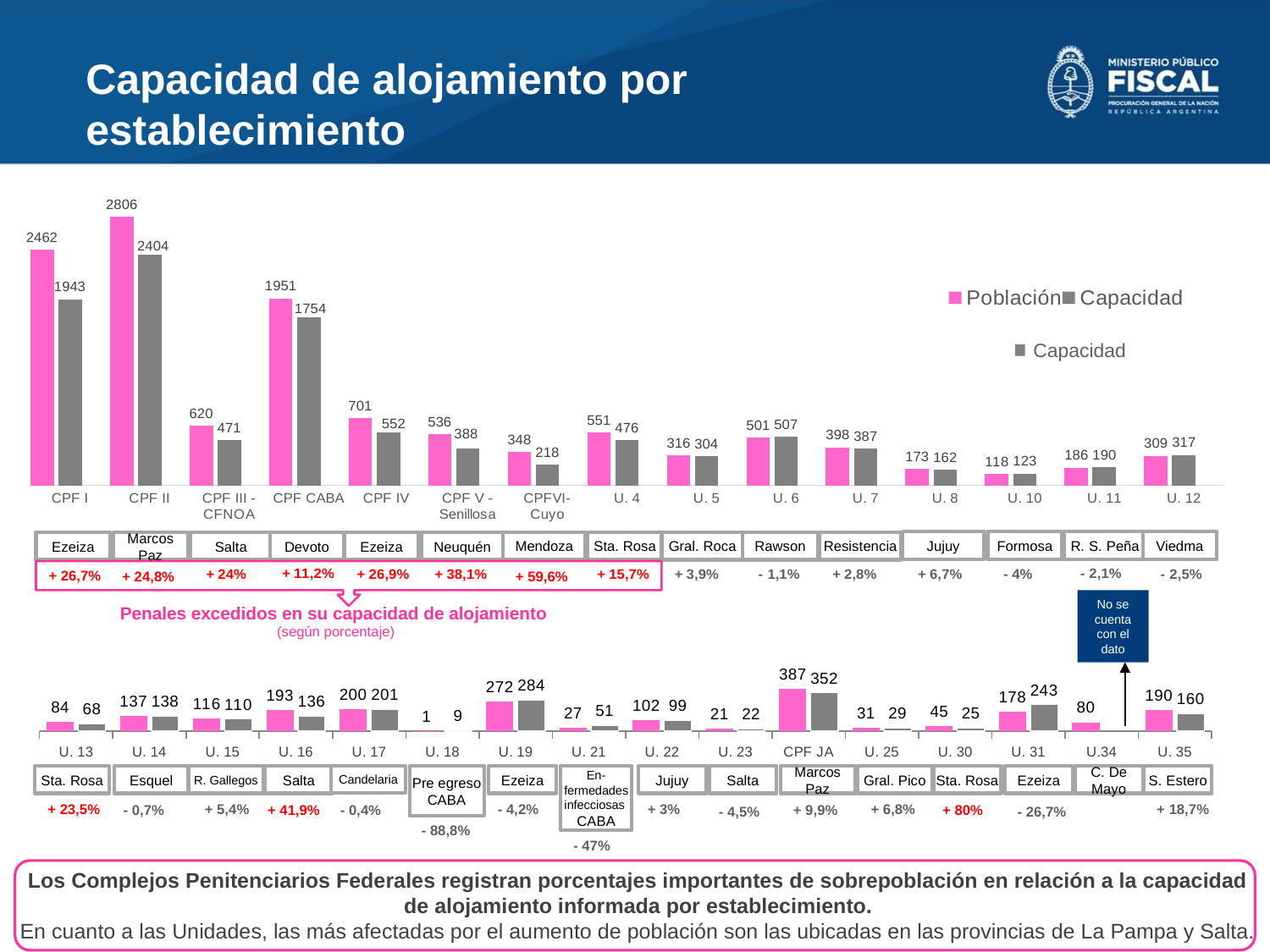
In the bottom chart, which establishment has the lowest Población? U. 18 In the bottom chart, what is the Población value for CPF JA? 387 In the top chart, what is the Población value for CPF II? 2806 In the top chart, which is larger for U. 6, Población or Capacidad? Capacidad How many series does the legend of the top chart list? 3 In the bottom chart, what is the Capacidad value for U. 31? 243 What type of chart is the top chart? Bar chart In the top chart, what is the difference between Población and Capacidad for CPF I? 519 How many establishments are shown on the x axis of the top chart? 15 In the top chart, what is the Capacidad value for CPF CABA? 1754 In the top chart, which establishment has the highest Población? CPF II In the bottom chart, what is the difference between Capacidad and Población for U. 21? 24